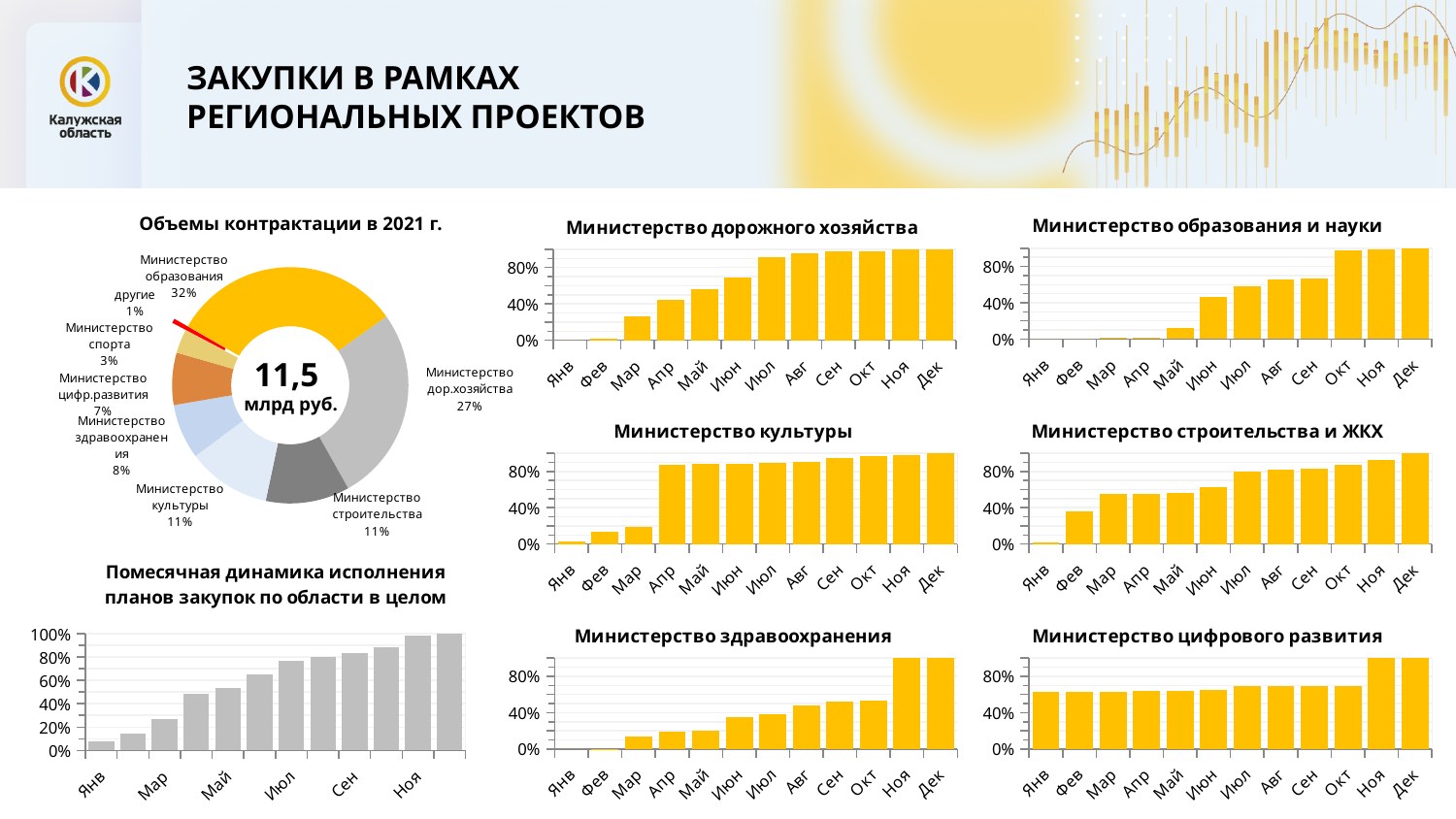
In the donut chart 'Объемы контрактации в 2021 г.', what share does Министерство дор.хозяйства have? 27% In the donut chart 'Объемы контрактации в 2021 г.', what is the difference in percentage points between Министерство образования and Министерство дор.хозяйства? 5 In the donut chart 'Объемы контрактации в 2021 г.', which has the larger share: Министерство здравоохранения or Министерство спорта? Министерство здравоохранения What total value is shown in the centre of the donut chart 'Объемы контрактации в 2021 г.'? 11,5 млрд руб. In the chart 'Министерство культуры', is the value for Апр greater or less than 80%? greater In the donut chart 'Объемы контрактации в 2021 г.', which category has the largest share? Министерство образования How many monthly bars are plotted in the chart 'Министерство здравоохранения'? 12 In the chart 'Министерство цифрового развития', is the value for Янв greater or less than 40%? greater In the donut chart 'Объемы контрактации в 2021 г.', what share does Министерство образования have? 32% What kind of chart is 'Помесячная динамика исполнения планов закупок по области в целом'? bar chart In the donut chart 'Объемы контрактации в 2021 г.', which category has the smallest share? другие In the chart 'Министерство дорожного хозяйства', is the value for Мар greater or less than 40%? less